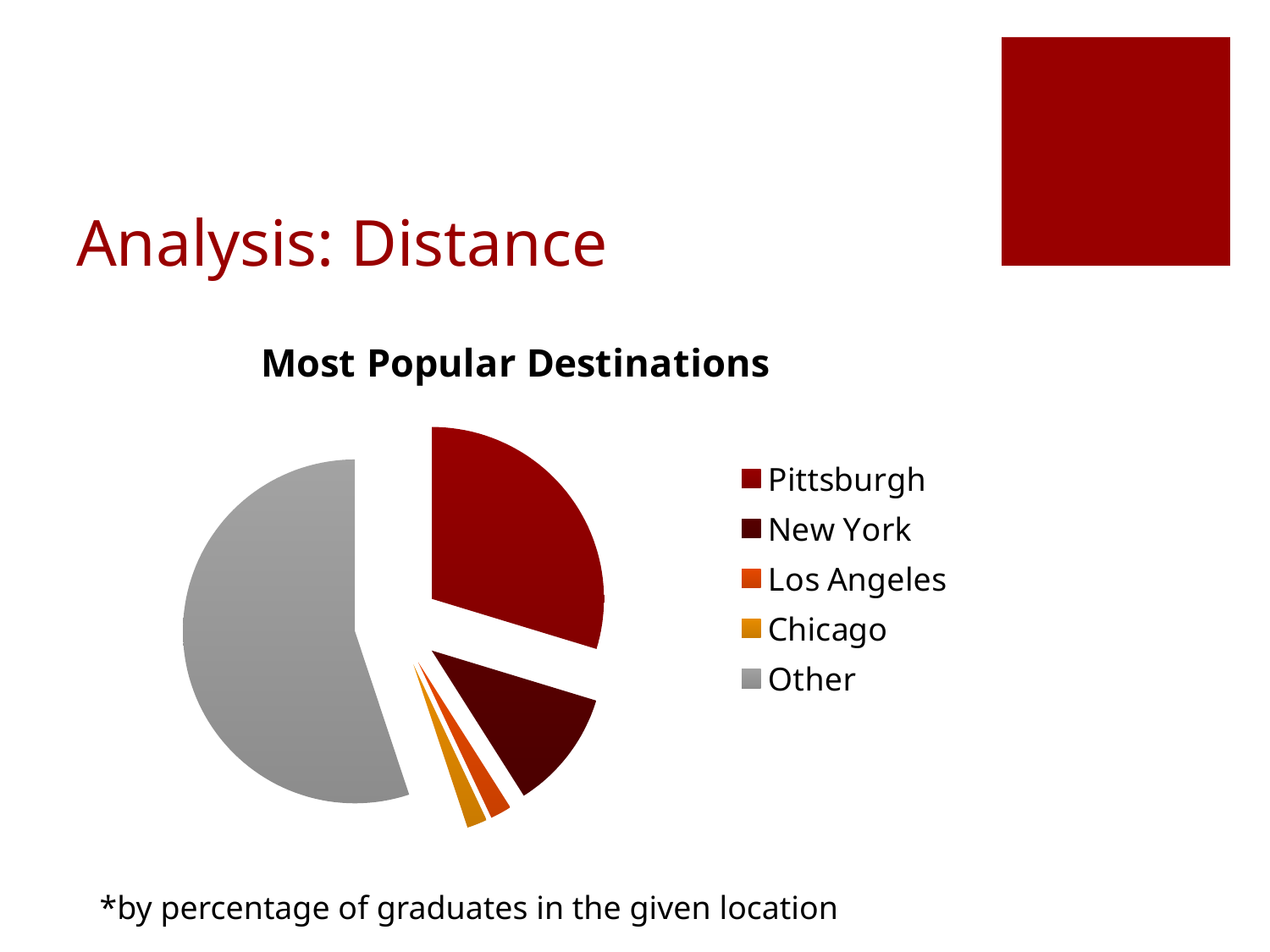
Which category is shown in grey in the pie chart? Other What kind of chart is shown on the slide? pie chart How many slices does the pie chart have? 5 Which slice is larger, New York or Los Angeles? New York Which slice is larger, Pittsburgh or Chicago? Pittsburgh Which of the named cities (excluding Other) has the largest slice? Pittsburgh Which category has the largest slice of the pie chart? Other What is the title of the chart? Most Popular Destinations Which slice is larger, Pittsburgh or New York? Pittsburgh How many categories does the legend of the pie chart list? 5